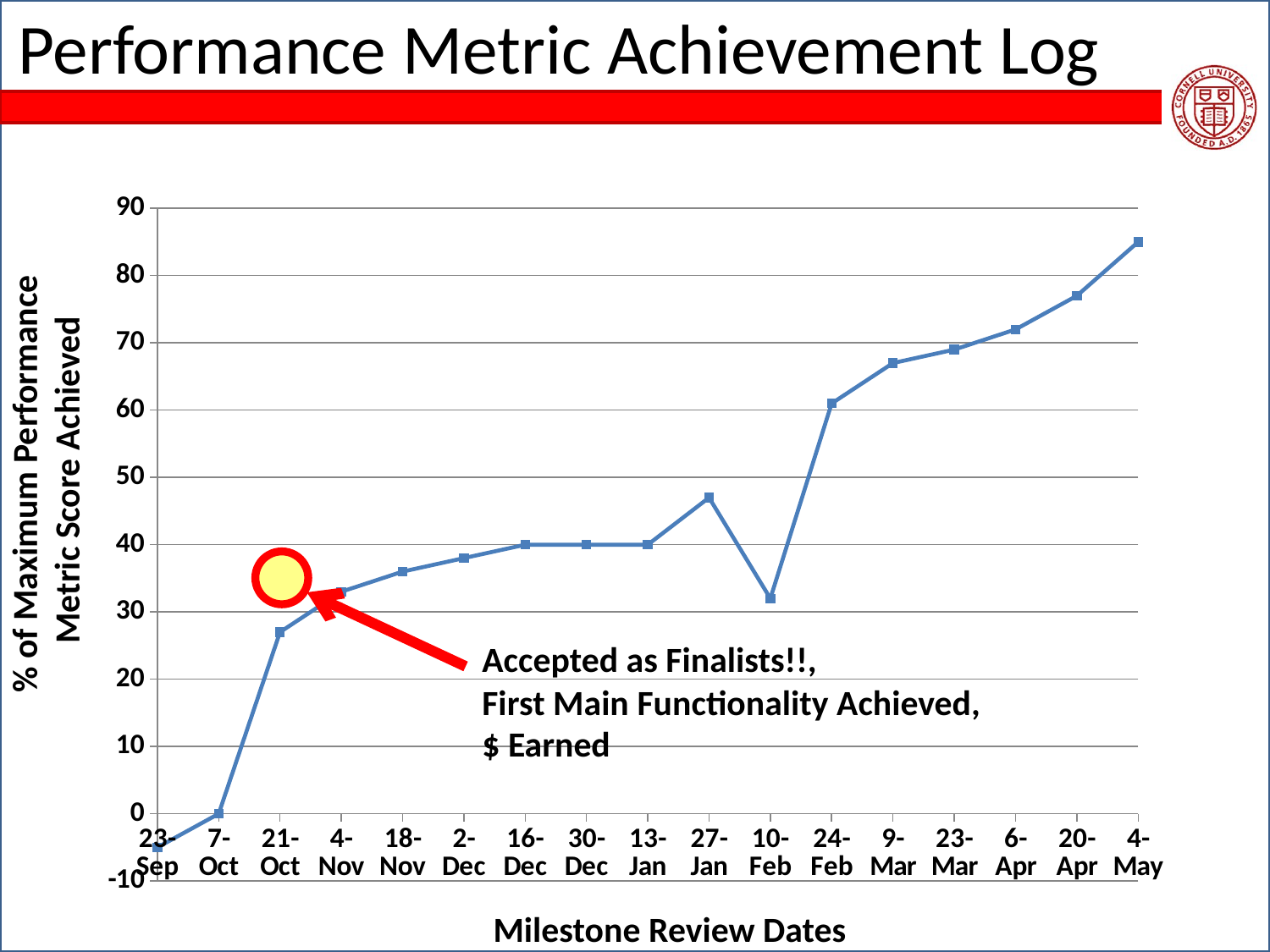
Which milestone review date has the lowest % of maximum performance metric score achieved? 23-Sep What kind of chart is shown on the slide? line chart What is the % of maximum performance metric score achieved on 30-Dec? 40 How many milestone review dates are plotted along the x axis? 17 Is the value for 21-Oct greater or less than 20? greater What is the % of maximum performance metric score achieved on 7-Oct? 0 Which has a higher value, 27-Jan or 10-Feb? 27-Jan Which milestone review date has the highest % of maximum performance metric score achieved? 4-May Is the value for 10-Feb greater or less than 40? less What is the title of the x axis? Milestone Review Dates Overall, do the values rise or fall from 23-Sep to 4-May? rise Is the value for 4-May greater or less than 80? greater